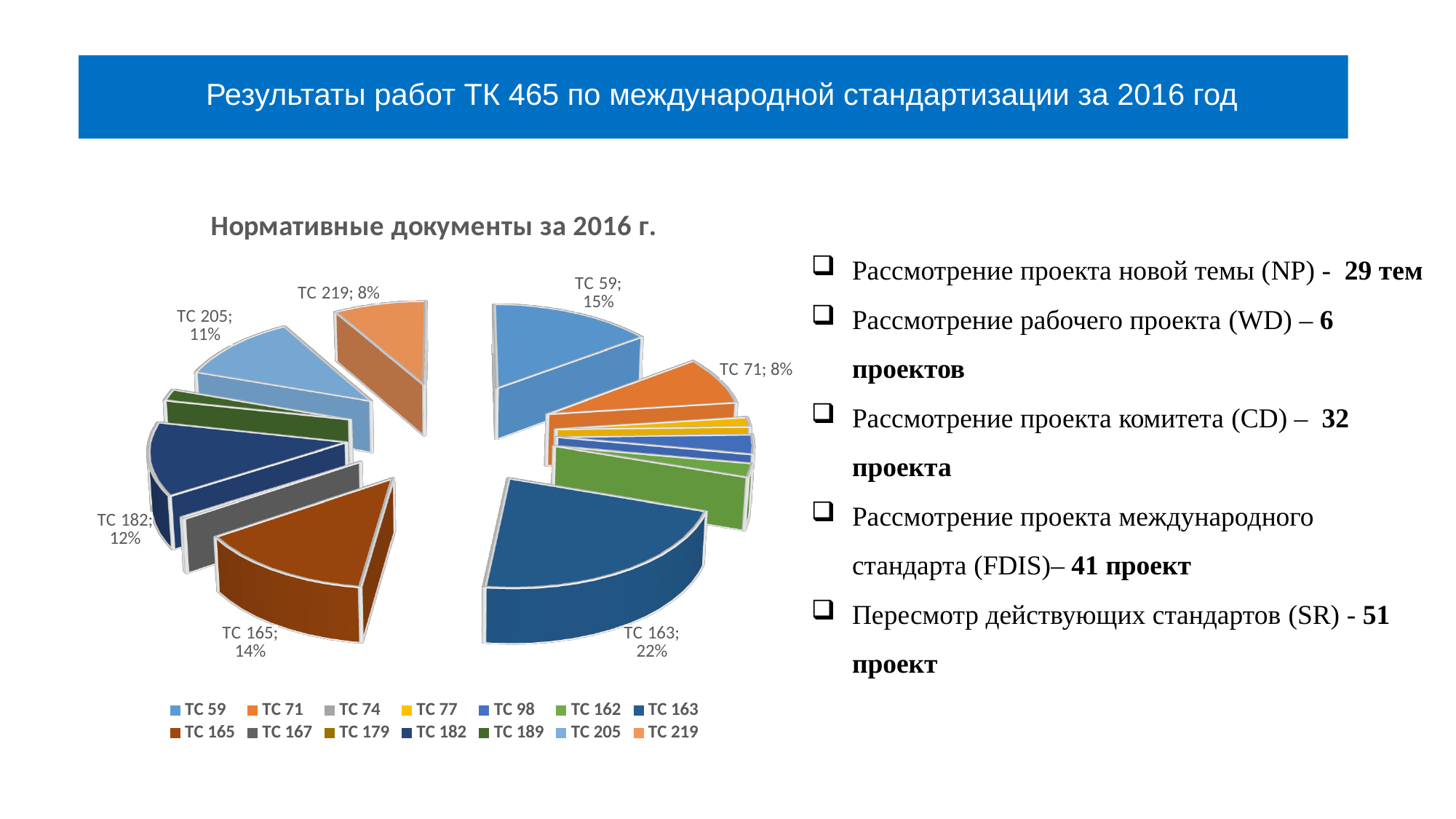
What kind of chart is shown on the slide? Pie chart Which has a larger share, TC 59 or TC 165? TC 59 Which has a larger share, TC 205 or TC 219? TC 205 What is the difference in percentage points between the shares of TC 163 and TC 59? 7 What percentage is shown for TC 205? 11% Which category has the largest slice of the pie? TC 163 What is the title of the chart? Нормативные документы за 2016 г. What percentage is shown for TC 219? 8% What percentage is shown for TC 59? 15% What share of the pie does TC 163 hold? 22% What percentage is shown for TC 182? 12% How many categories does the legend list? 14